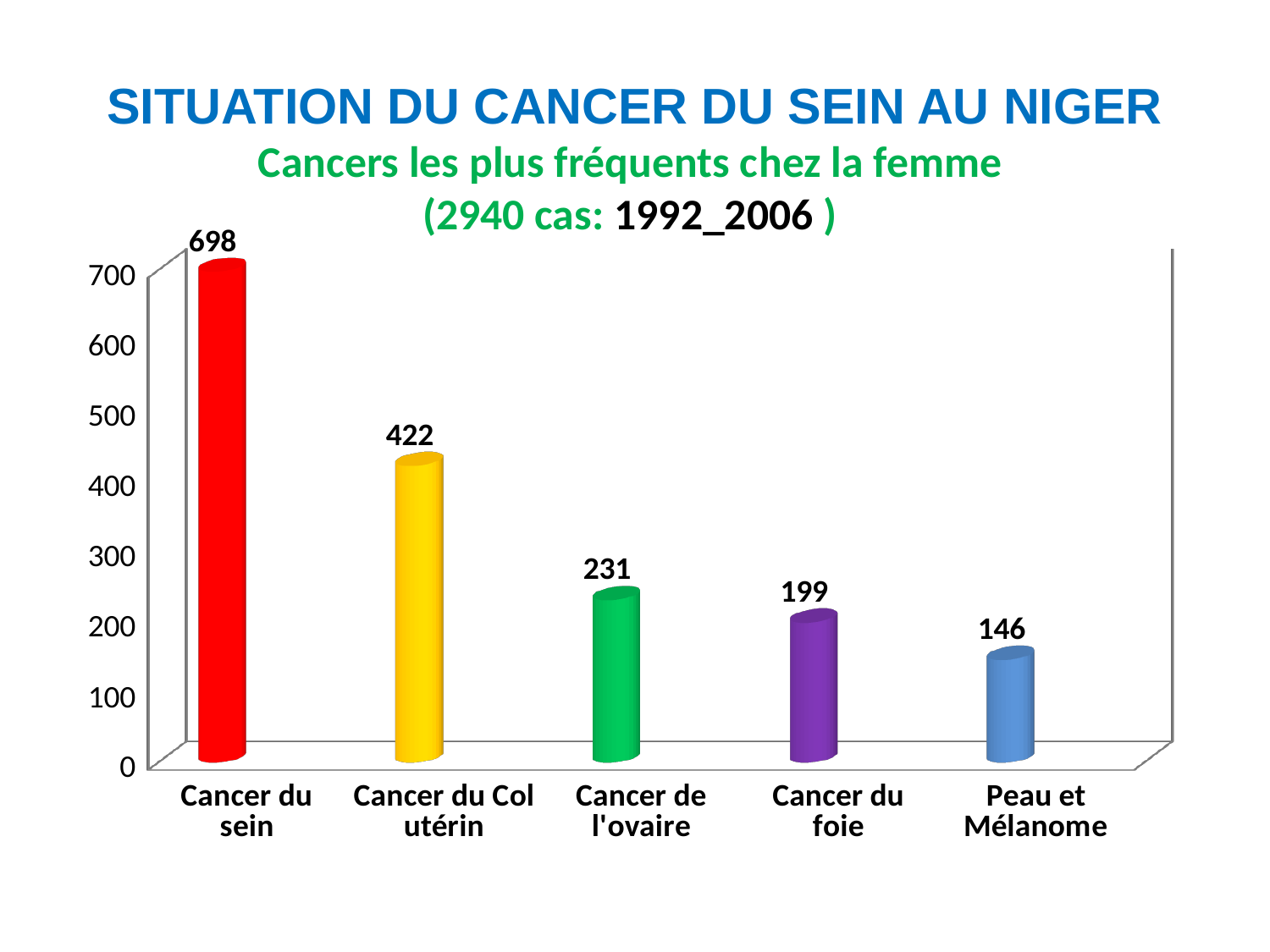
What is the value for Cancer du Col utérin? 422 Do the values rise or fall from left to right across the categories? Fall What is the difference between the values for Cancer du sein and Cancer du Col utérin? 276 Which category has the highest value? Cancer du sein What kind of chart is shown on the slide? Bar chart What is the value for Peau et Mélanome? 146 How many categories are shown on the chart? 5 What is the value for Cancer de l'ovaire? 231 Which is larger, the value for Cancer de l'ovaire or the value for Cancer du foie? Cancer de l'ovaire Which category has the lowest value? Peau et Mélanome What is the value for Cancer du foie? 199 What is the value for Cancer du sein? 698